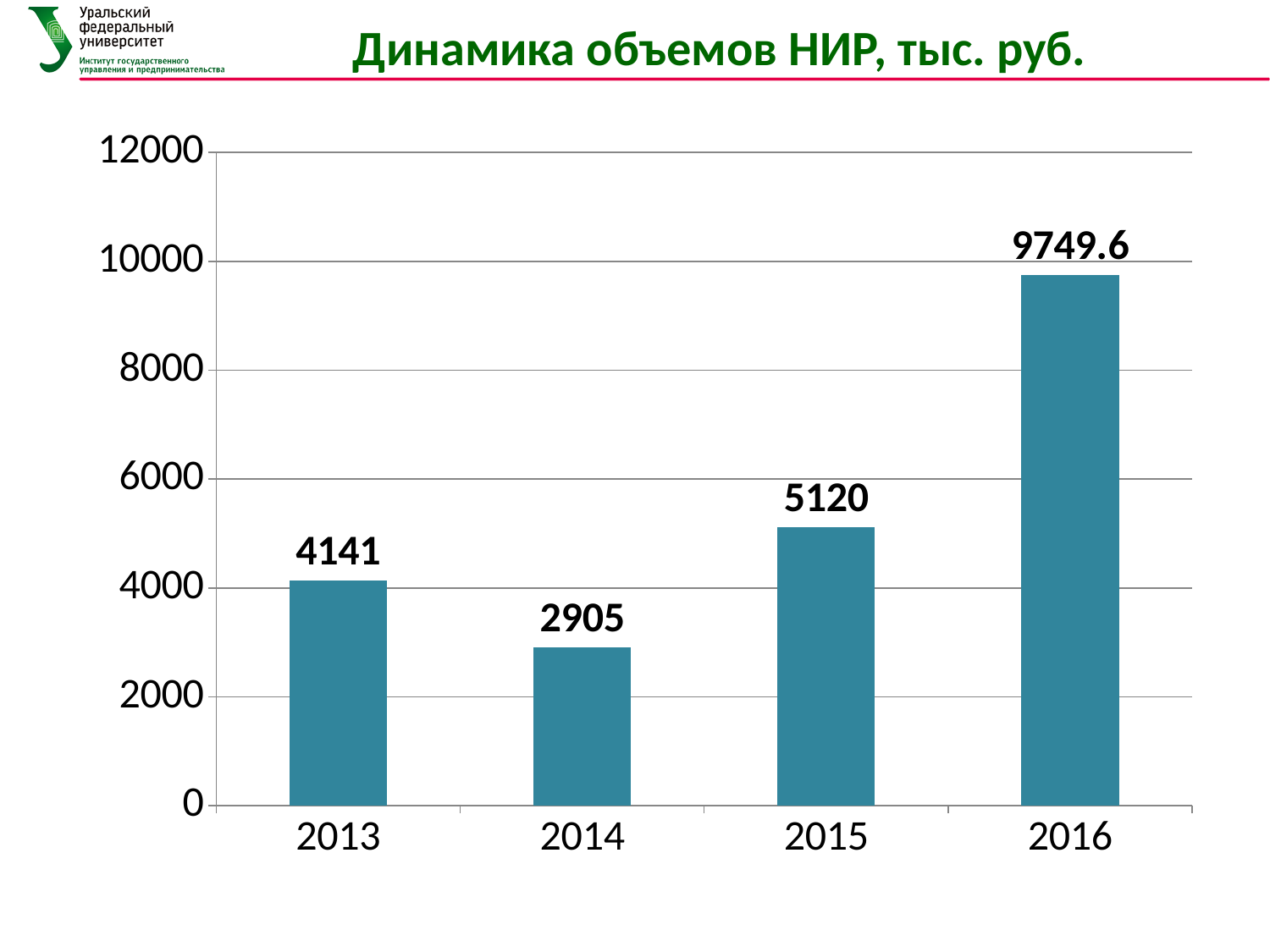
What is the title of the chart? Динамика объемов НИР, тыс. руб. What is the value for 2016? 9749.6 What is the value for 2013? 4141 What kind of chart is shown on the slide? bar chart How many years are shown on the x axis? 4 Which year has the highest value? 2016 Which is larger, the value for 2013 or the value for 2014? 2013 What is the difference between the values for 2016 and 2015? 4629.6 What is the difference between the values for 2015 and 2013? 979 What is the value for 2014? 2905 What is the value for 2015? 5120 Which year has the lowest value? 2014